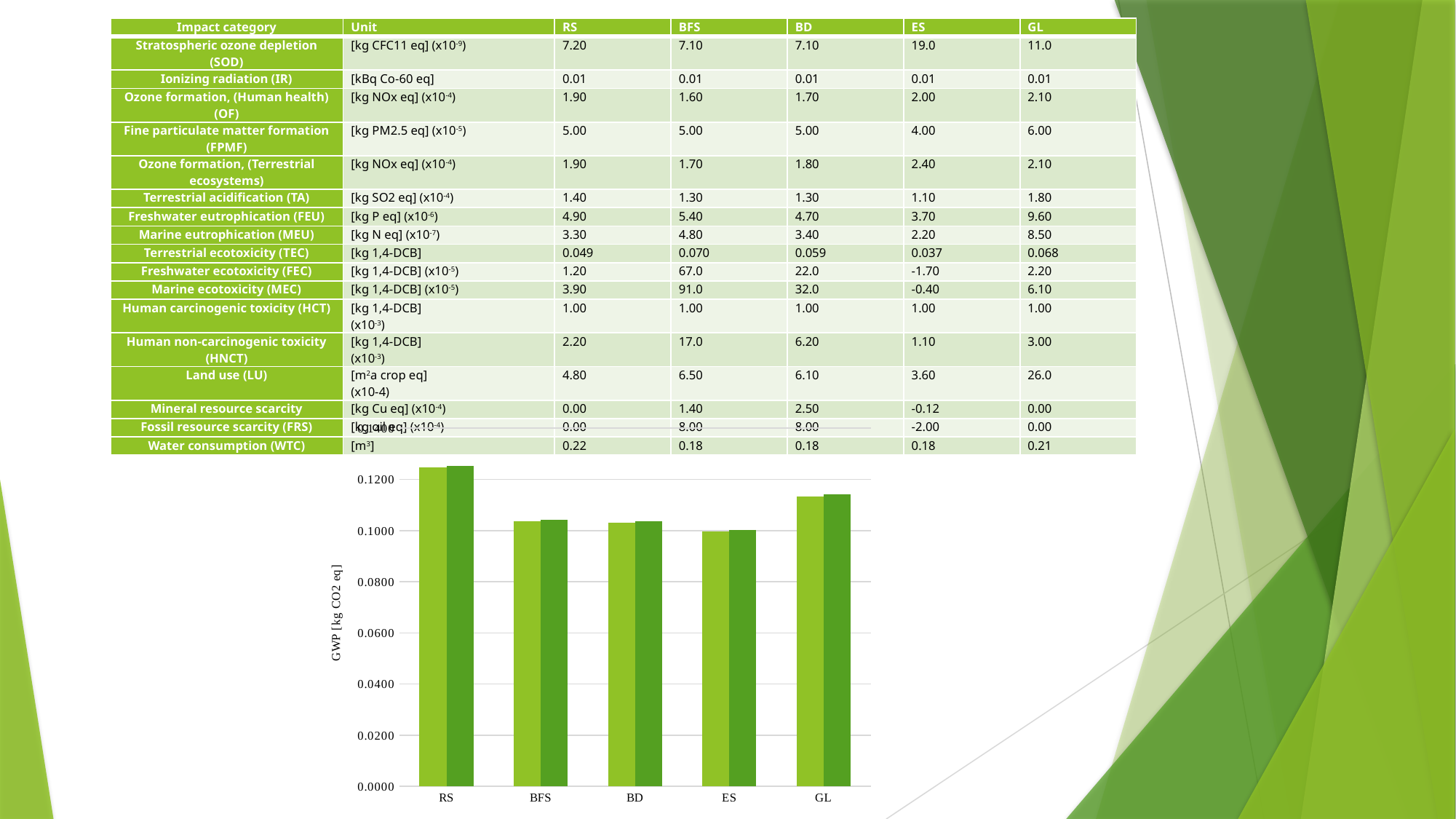
In the bar chart, which has the larger GWP, GL or BFS? GL In the bar chart, which has the larger GWP, RS or GL? RS In the bar chart, is the GWP value for RS greater or less than 0.1200? greater Which category has the highest GWP in the bar chart? RS How many bars are plotted for each category in the bar chart? 2 What kind of chart is shown below the table on the slide? bar chart What is the label of the y axis of the bar chart? GWP [kg CO2 eq] In the bar chart, is the GWP value for BD greater or less than 0.0800? greater In the bar chart, which has the larger GWP, RS or ES? RS In the bar chart, is the GWP value for BFS greater or less than 0.1200? less How many categories are shown on the x axis of the bar chart? 5